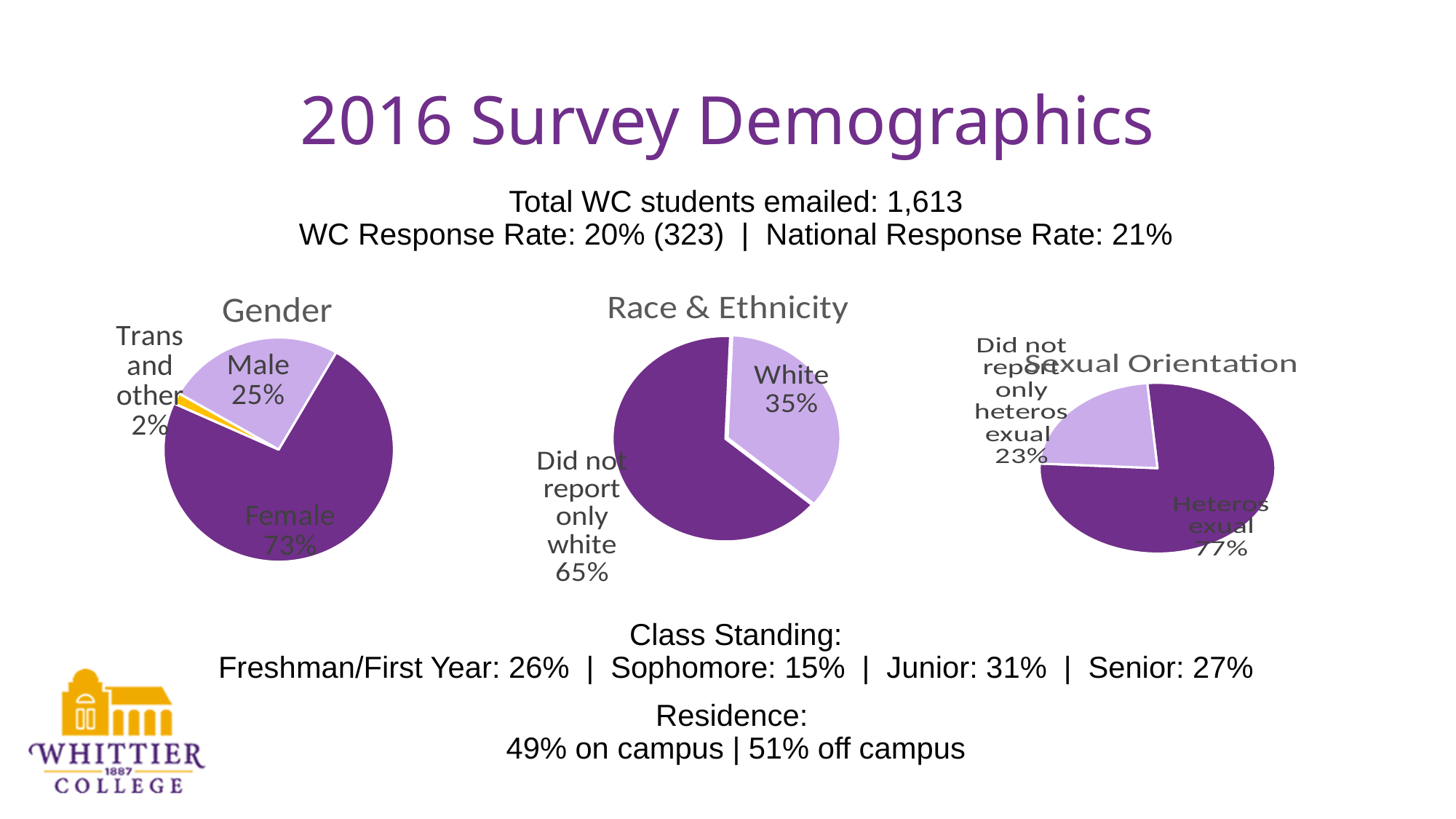
How many slices does the Gender pie chart have? 3 How many pie charts are shown on the slide? 3 In the Gender chart, what share of respondents are Female? 73% What type of chart is used for the Race & Ethnicity data? Pie chart In the Race & Ethnicity chart, what is the difference between the 'Did not report only white' and 'White' slices? 30 percentage points In the Gender chart, what percentage is labelled Trans and other? 2% In the Gender chart, which category has the smallest slice? Trans and other In the Sexual Orientation chart, which slice is larger: Heterosexual or Did not report only heterosexual? Heterosexual In the Race & Ethnicity chart, what percentage did not report only white? 65% In the Race & Ethnicity chart, what percentage is labelled White? 35% In the Gender chart, what percentage is labelled Male? 25% In the Sexual Orientation chart, what percentage is labelled Heterosexual? 77%